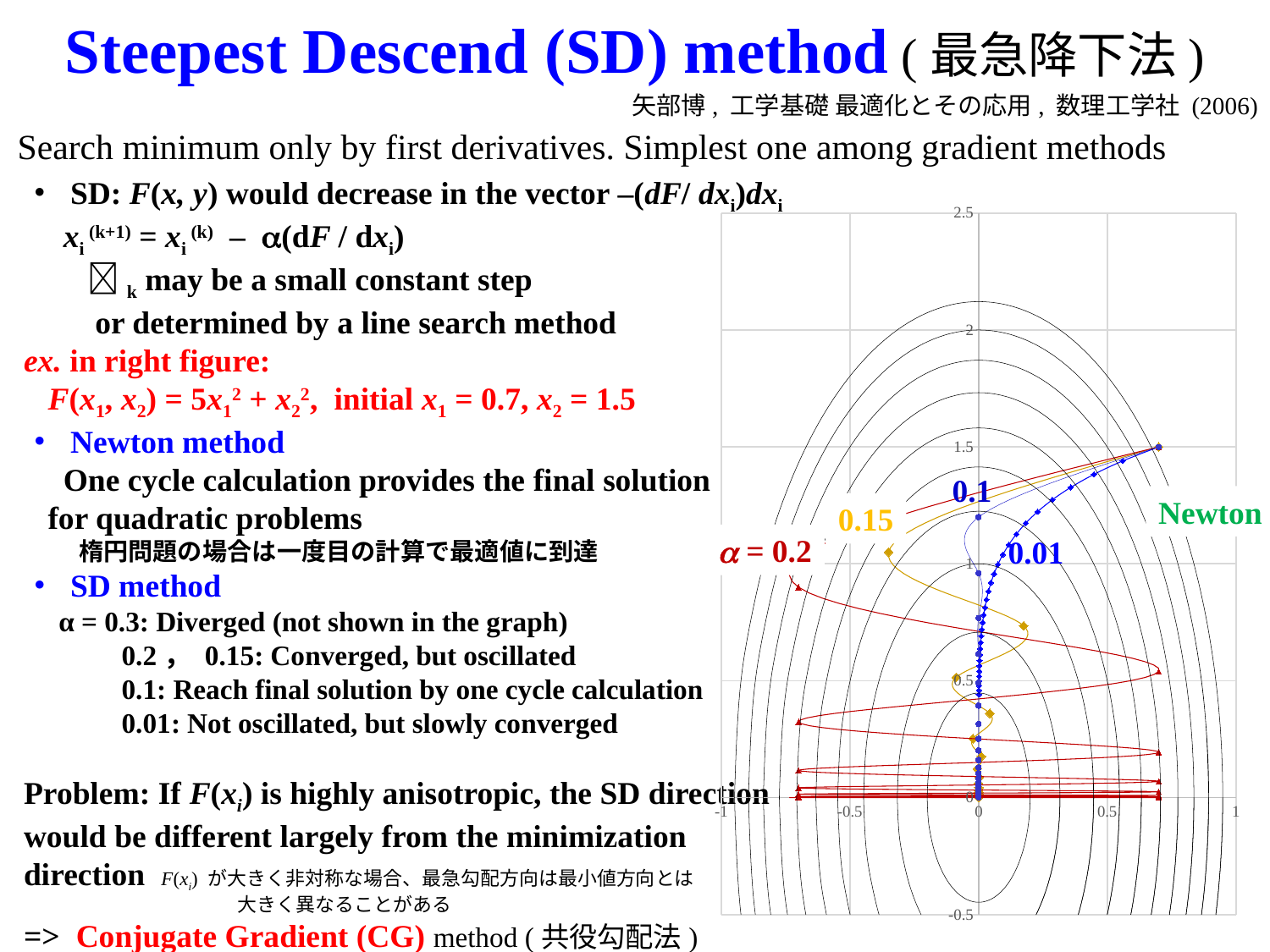
What is the lowest tick value shown on the y axis of the chart? -0.5 What is the lowest tick value shown on the x axis of the chart? -1 What colour is the α = 0.01 trajectory on the chart? blue At which point do all the trajectories on the chart start? (0.7, 1.5) How many labelled trajectories are drawn on the chart? 5 What colour is the α = 0.15 trajectory on the chart? gold Is the leftmost x value reached by the α = 0.2 trajectory greater or less than -0.5? less Toward which point do the trajectories on the chart converge? (0, 0) What kind of chart is shown on the right of the slide? line chart Which labelled trajectory oscillates most widely across the x axis? α = 0.2 What is the highest tick value shown on the y axis of the chart? 2.5 Is the starting y value of the trajectories greater or less than 1? greater